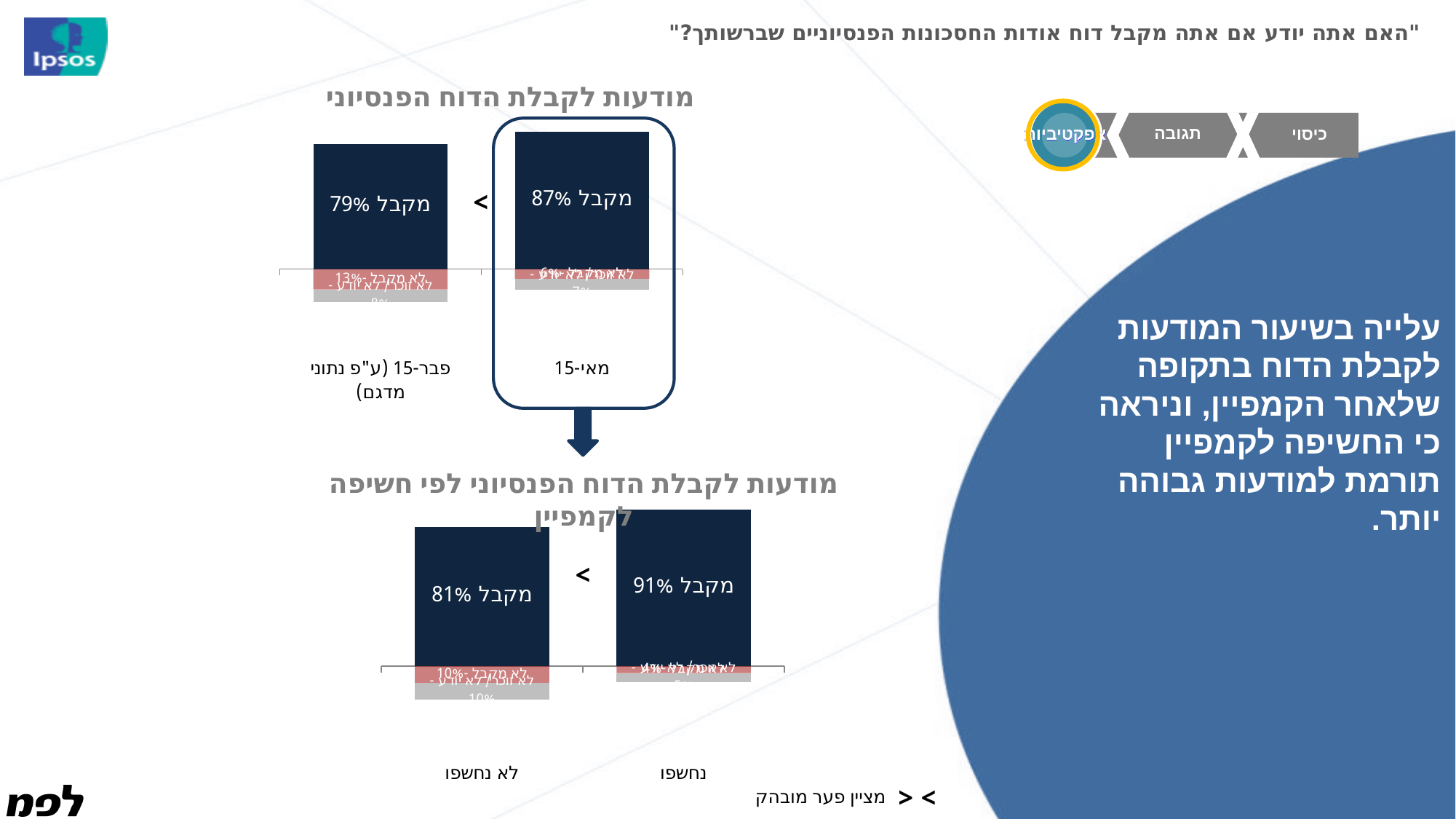
In the bottom chart 'מודעות לקבלת הדוח הפנסיוני לפי חשיפה לקמפיין', what is the 'מקבל' value for נחשפו? 91% In the top chart 'מודעות לקבלת הדוח הפנסיוני', what is the difference in 'מקבל' share between מאי-15 and פבר-15? 8 percentage points What is the title of the bottom chart on the slide? מודעות לקבלת הדוח הפנסיוני לפי חשיפה לקמפיין In the top chart 'מודעות לקבלת הדוח הפנסיוני', what is the 'מקבל' value for פבר-15? 79% What type of chart is the top chart 'מודעות לקבלת הדוח הפנסיוני'? Stacked bar chart In the bottom chart 'מודעות לקבלת הדוח הפנסיוני לפי חשיפה לקמפיין', what is the 'לא מקבל' value for לא נחשפו? 10% In the bottom chart 'מודעות לקבלת הדוח הפנסיוני לפי חשיפה לקמפיין', what is the 'מקבל' value for לא נחשפו? 81% In the top chart 'מודעות לקבלת הדוח הפנסיוני', which period has the higher 'מקבל' share, מאי-15 or פבר-15? מאי-15 In the bottom chart 'מודעות לקבלת הדוח הפנסיוני לפי חשיפה לקמפיין', what is the difference in 'מקבל' share between נחשפו and לא נחשפו? 10 percentage points In the bottom chart 'מודעות לקבלת הדוח הפנסיוני לפי חשיפה לקמפיין', which group has the higher 'מקבל' share? נחשפו How many periods (categories) are shown in the top chart 'מודעות לקבלת הדוח הפנסיוני'? 2 In the top chart 'מודעות לקבלת הדוח הפנסיוני', what is the 'מקבל' value for מאי-15? 87%